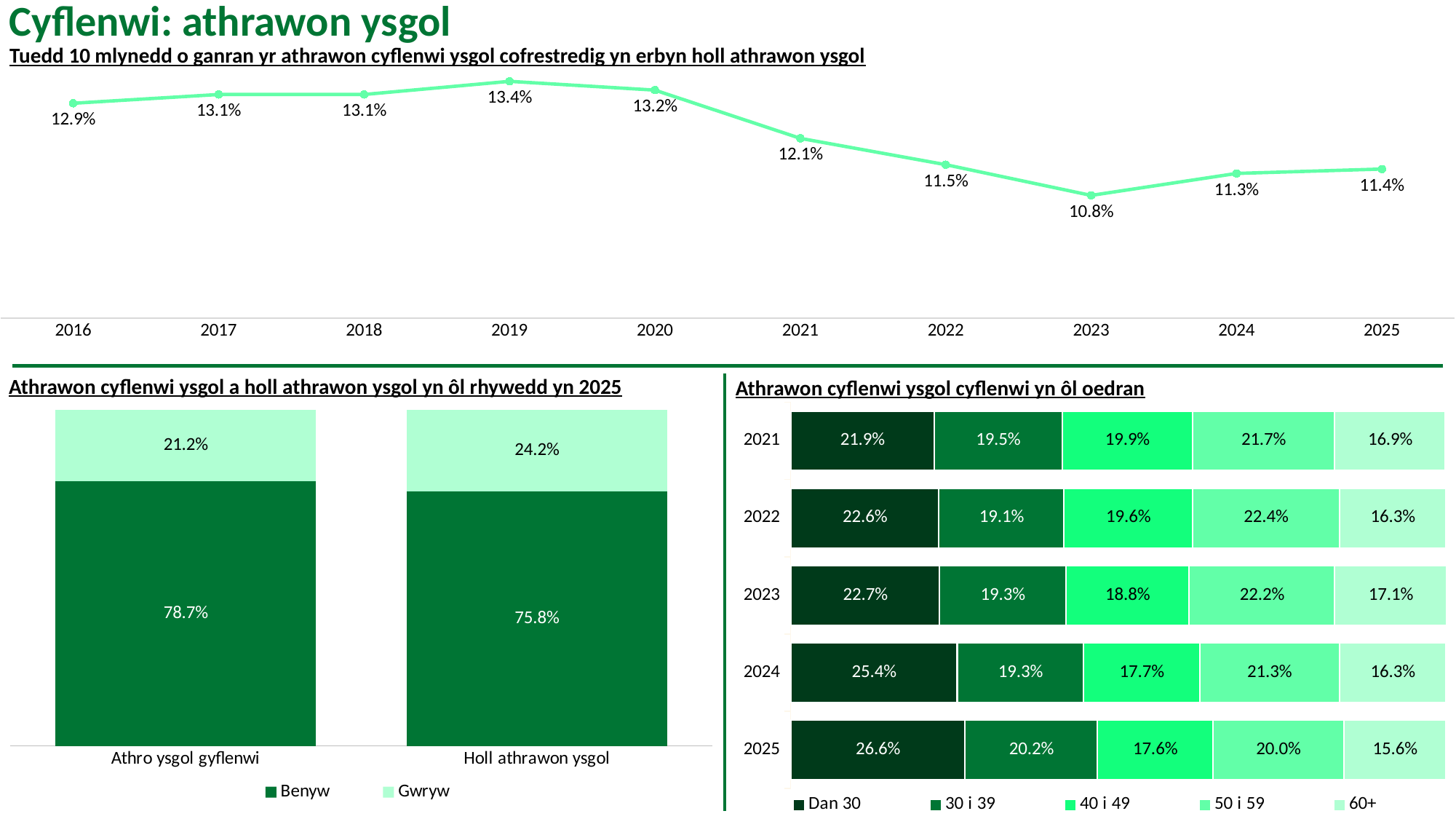
In the top line chart (Tuedd 10 mlynedd), what is the value for 2019? 13.4% In the bottom-right chart (yn ôl oedran), what is the Dan 30 value for 2025? 26.6% In the bottom-right chart (yn ôl oedran), which year has the highest Dan 30 value? 2025 In the top line chart (Tuedd 10 mlynedd), what is the difference between the 2016 value and the 2025 value? 1.5% In the bottom-left chart (yn ôl rhywedd yn 2025), how many series does the legend list? 2 In the top line chart (Tuedd 10 mlynedd), do the values rise or fall between 2020 and 2023? fall In the bottom-left chart (yn ôl rhywedd yn 2025), what is the Benyw value for Athro ysgol gyflenwi? 78.7% In the top line chart (Tuedd 10 mlynedd), which year has the lowest value? 2023 In the top line chart (Tuedd 10 mlynedd), which year has the highest value? 2019 In the bottom-left chart (yn ôl rhywedd yn 2025), which is larger: the Gwryw value for Athro ysgol gyflenwi or for Holl athrawon ysgol? Holl athrawon ysgol In the top line chart (Tuedd 10 mlynedd), how many years are plotted on the x axis? 10 In the bottom-right chart (yn ôl oedran), what kind of chart is it? stacked bar chart